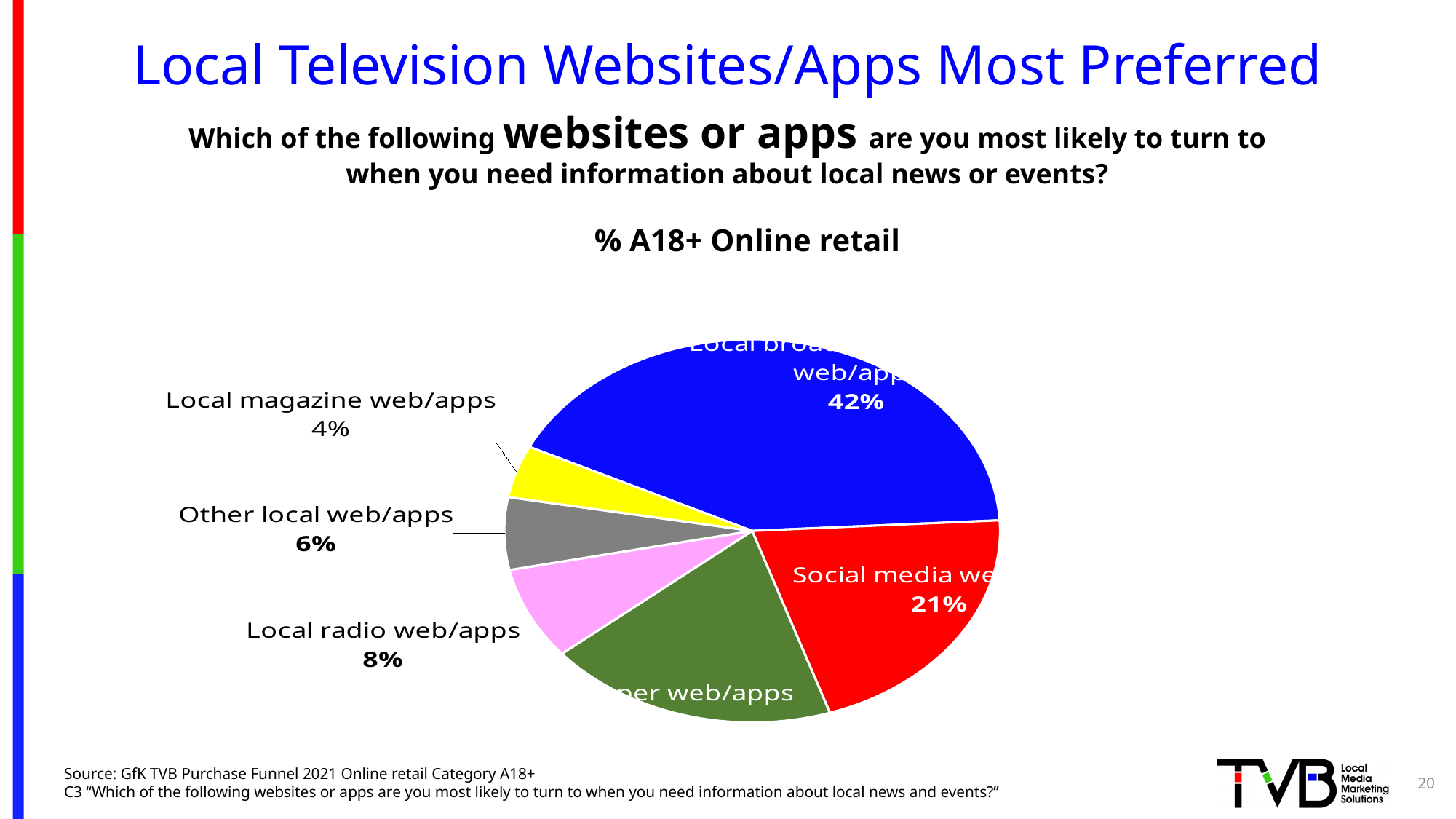
What is the title of the chart? % A18+ Online retail What percentage is shown for Local magazine web/apps? 4% What percentage is shown for the Social media web/apps slice? 21% What percentage is shown for Other local web/apps? 6% What percentage is shown on the largest slice of the pie? 42% How many percentage points higher is Social media web/apps than Local radio web/apps? 13% What kind of chart is shown on the slide? Pie chart Which category has the smallest share of the pie? Local magazine web/apps Which is larger, Local radio web/apps or Other local web/apps? Local radio web/apps What percentage is shown for Local radio web/apps? 8% How many slices does the pie chart have? 6 What is the difference between Other local web/apps and Local magazine web/apps? 2%